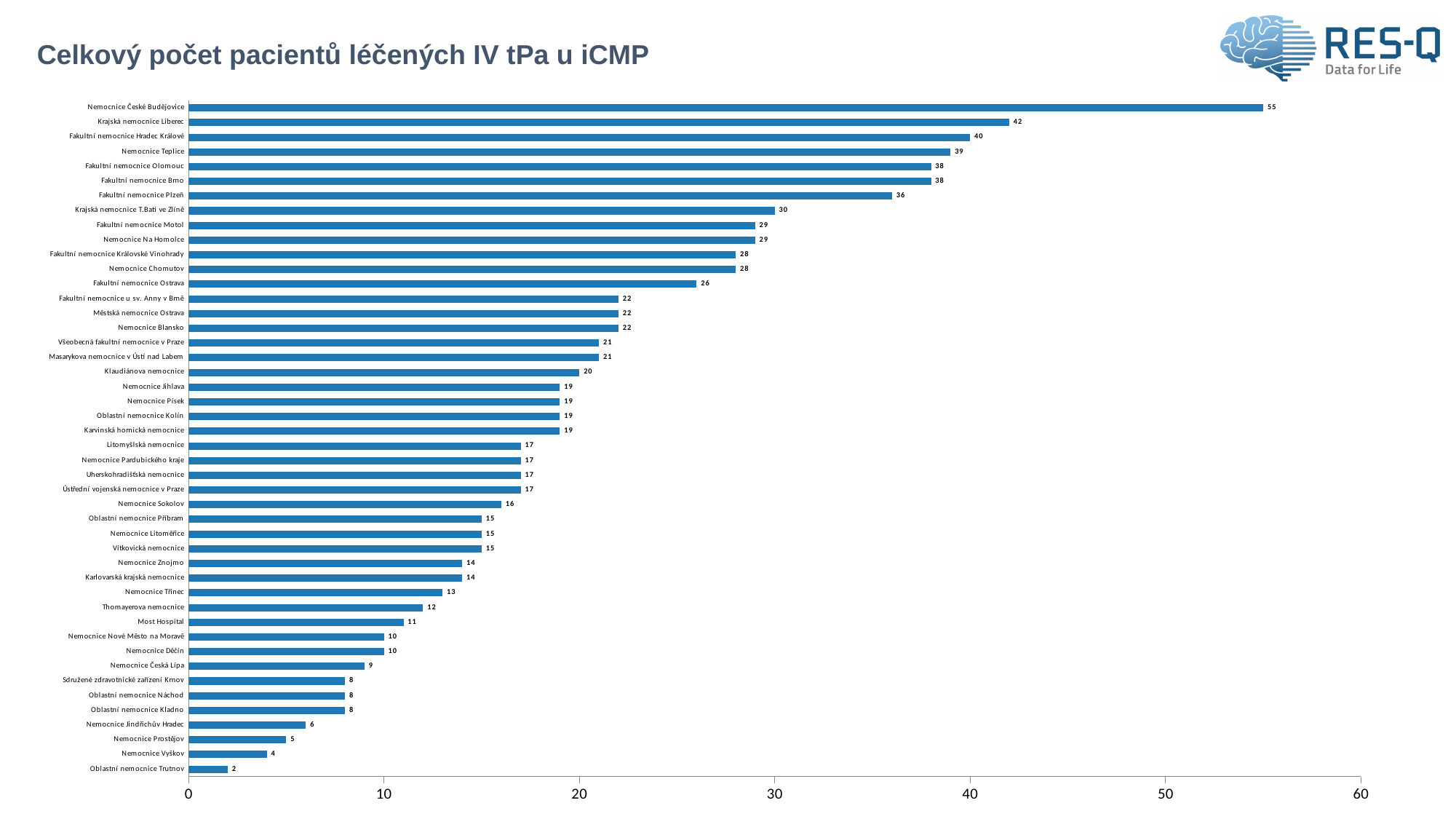
What is the value for Fakultní nemocnice Motol? 29 What is the value for Nemocnice Sokolov? 16 How many hospitals are shown in the chart? 46 What is the difference between the values for Krajská nemocnice Liberec and Fakultní nemocnice Hradec Králové? 2 What kind of chart is shown on the slide? Bar chart What is the value for Nemocnice České Budějovice? 55 Which is larger, the value for Fakultní nemocnice Plzeň or the value for Krajská nemocnice T.Bati ve Zlíně? Fakultní nemocnice Plzeň What is the difference between the values for Nemocnice České Budějovice and Nemocnice Teplice? 16 What is the value for Oblastní nemocnice Trutnov? 2 Which hospital has the lowest value? Oblastní nemocnice Trutnov Which hospital has the highest value? Nemocnice České Budějovice What is the title of the slide? Celkový počet pacientů léčených IV tPa u iCMP